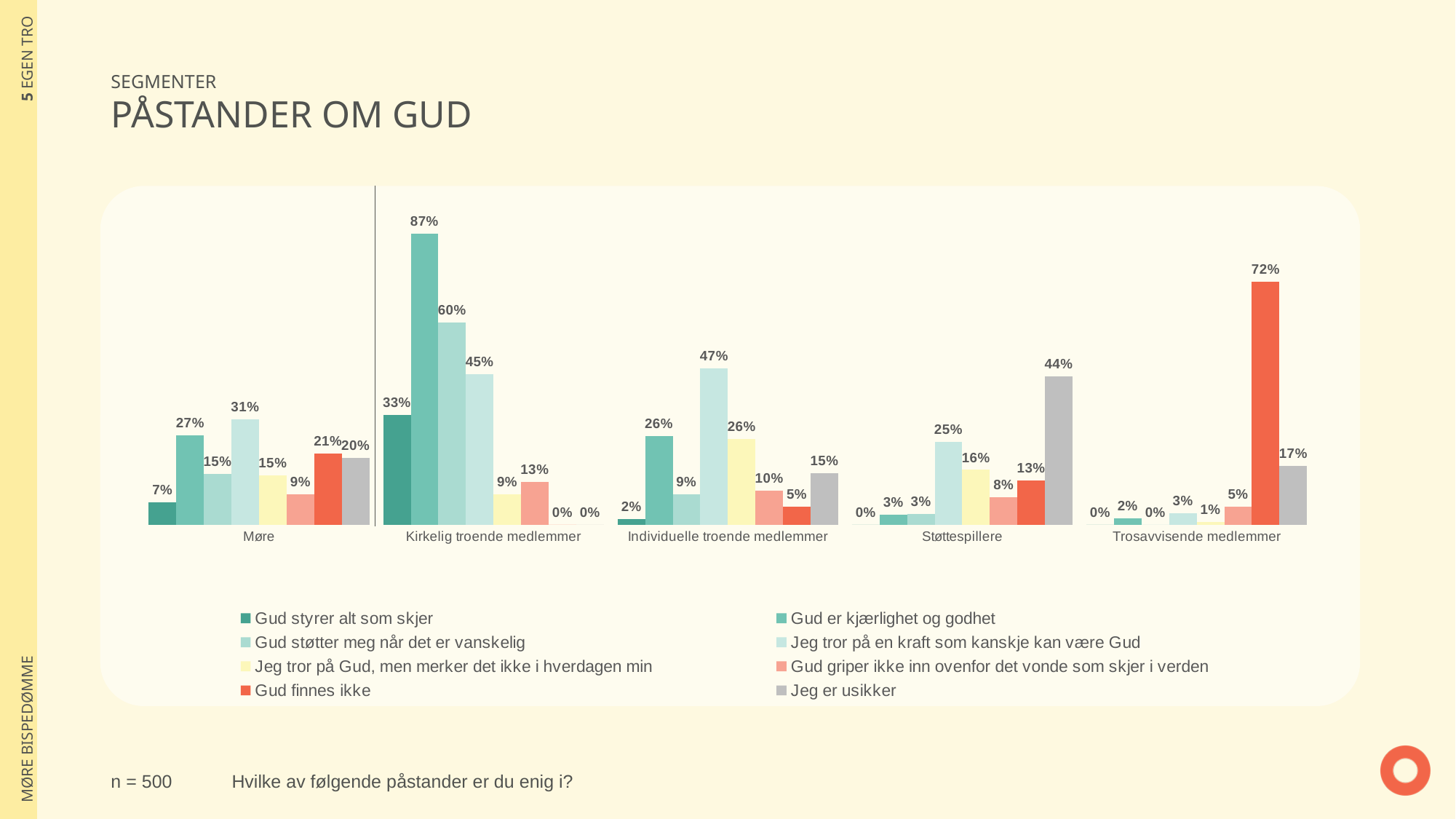
What is the value for "Gud er kjærlighet og godhet" in the Kirkelig troende medlemmer group? 87% What is the value for "Jeg er usikker" in the Støttespillere group? 44% What is the value for "Jeg tror på en kraft som kanskje kan være Gud" in the Møre group? 31% Which series has the highest value in the Individuelle troende medlemmer group? Jeg tror på en kraft som kanskje kan være Gud How many series does the legend list? 8 What is the difference between "Gud er kjærlighet og godhet" and "Gud støtter meg når det er vanskelig" in the Kirkelig troende medlemmer group? 27% Which series has the lowest value in the Møre group? Gud styrer alt som skjer Which is larger in the Støttespillere group: "Jeg tror på Gud, men merker det ikke i hverdagen min" or "Gud finnes ikke"? Jeg tror på Gud, men merker det ikke i hverdagen min What is the sample size stated on the slide? n = 500 What kind of chart is shown on the slide? bar chart What is the value for "Gud finnes ikke" in the Trosavvisende medlemmer group? 72% How many segment categories are shown along the x axis? 5